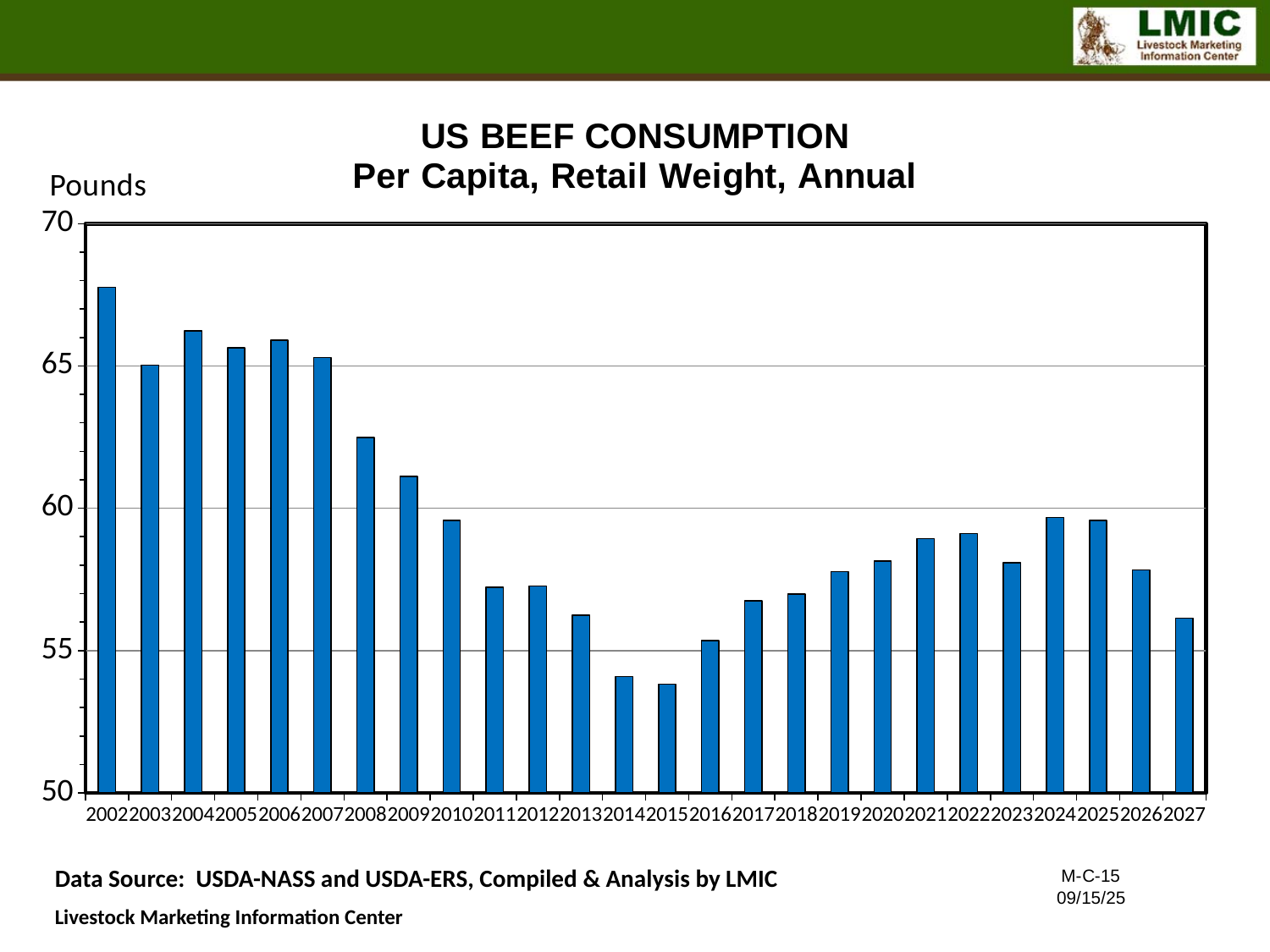
What unit is shown on the y axis of the chart? Pounds Do the values generally rise or fall from 2002 to 2015? fall Which is larger, the value for 2008 or the value for 2020? 2008 Which is larger, the value for 2024 or the value for 2027? 2024 Is the value for 2002 greater or less than 65? greater How many years (bars) are plotted on the chart? 26 Is the value for 2008 greater or less than 60? greater Is the value for 2027 greater or less than 55? greater Which year has the highest per capita beef consumption? 2002 What kind of chart is shown on the slide? Bar chart